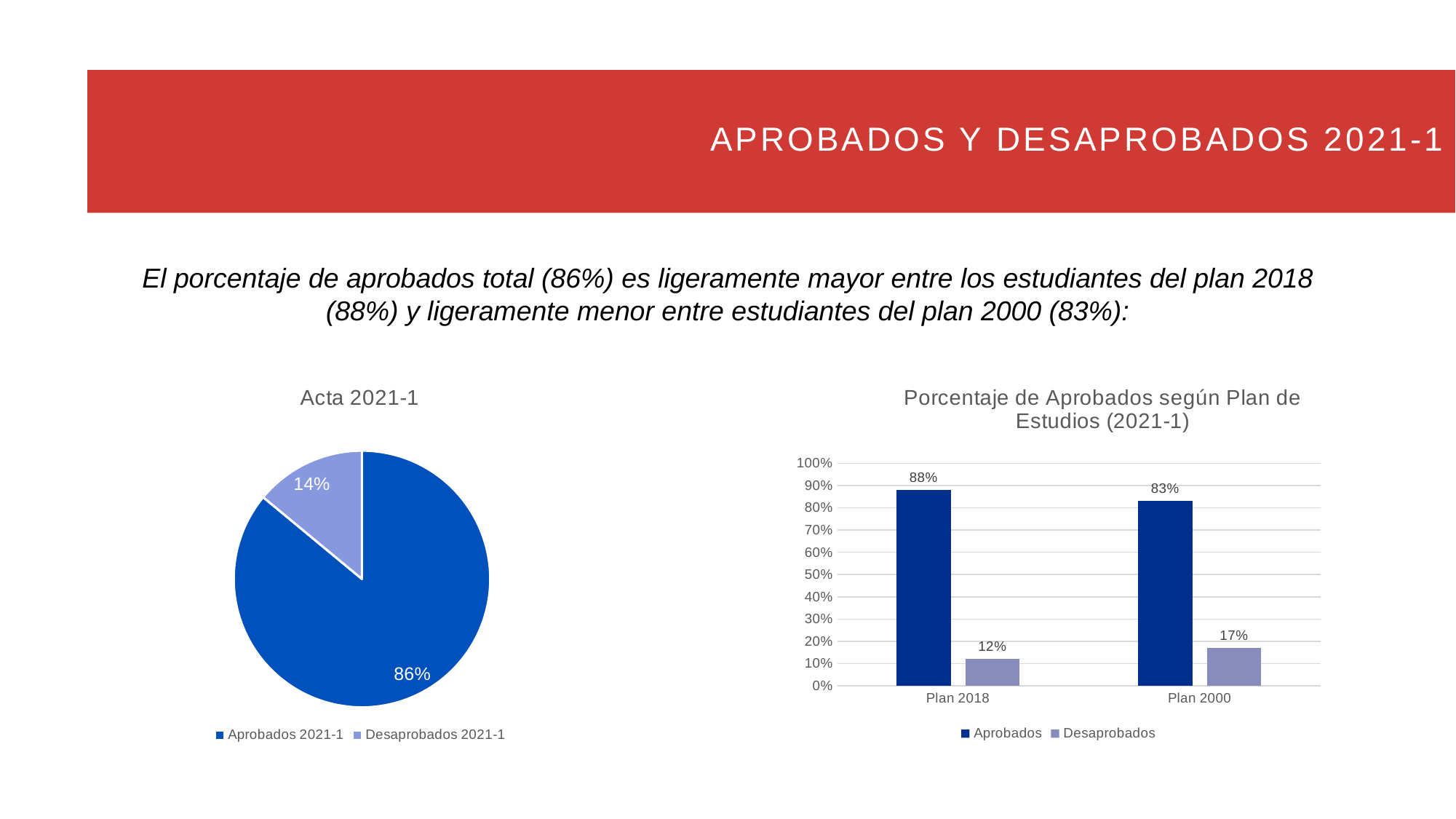
In the 'Porcentaje de Aprobados según Plan de Estudios (2021-1)' chart, how many series does the legend list? 2 In the 'Porcentaje de Aprobados según Plan de Estudios (2021-1)' chart, what is the value for 'Desaprobados' in 'Plan 2000'? 17% In the 'Porcentaje de Aprobados según Plan de Estudios (2021-1)' chart, how many categories are on the x axis? 2 In the 'Porcentaje de Aprobados según Plan de Estudios (2021-1)' chart, what is the value for 'Aprobados' in 'Plan 2018'? 88% In the 'Acta 2021-1' chart, how many slices does the pie have? 2 In the 'Acta 2021-1' chart, what share of the pie is 'Aprobados 2021-1'? 86% In the 'Acta 2021-1' chart, what is the value for 'Desaprobados 2021-1'? 14% In the 'Porcentaje de Aprobados según Plan de Estudios (2021-1)' chart, which bar is the lowest? Desaprobados, Plan 2018 In the 'Porcentaje de Aprobados según Plan de Estudios (2021-1)' chart, which plan has the higher 'Desaprobados' value? Plan 2000 In the 'Acta 2021-1' chart, what kind of chart is shown? pie chart In the 'Porcentaje de Aprobados según Plan de Estudios (2021-1)' chart, what kind of chart is shown? bar chart In the 'Porcentaje de Aprobados según Plan de Estudios (2021-1)' chart, what is the difference between 'Aprobados' for 'Plan 2018' and 'Plan 2000'? 5%